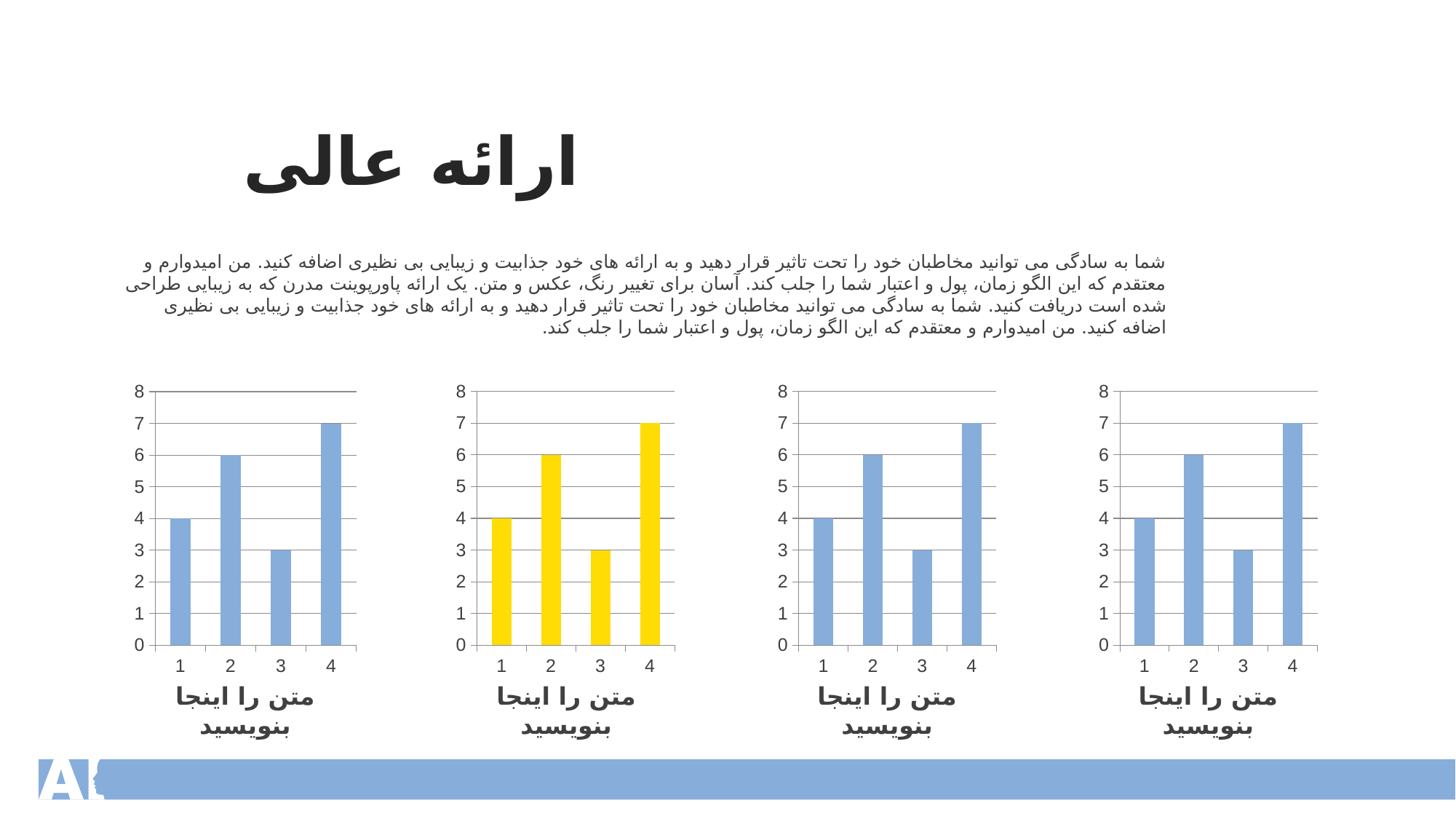
How many categories are shown on the x axis of the leftmost chart? 4 What colour are the bars in the second chart from the left? yellow In the second chart from the left (yellow bars), what is the difference between the values for category 4 and category 3? 4 In the rightmost chart, is the value for category 2 greater or less than 5? greater In the second chart from the left (yellow bars), what is the value for category 1? 4 What kind of chart is the second chart from the left? bar chart In the third chart from the left, what is the value for category 3? 3 In the rightmost chart, which category has the highest value? 4 In the leftmost chart, which category has the lowest value? 3 In the third chart from the left, which is larger, the value for category 2 or the value for category 1? category 2 In the leftmost chart, what is the value for category 4? 7 How many charts are shown on the slide? 4